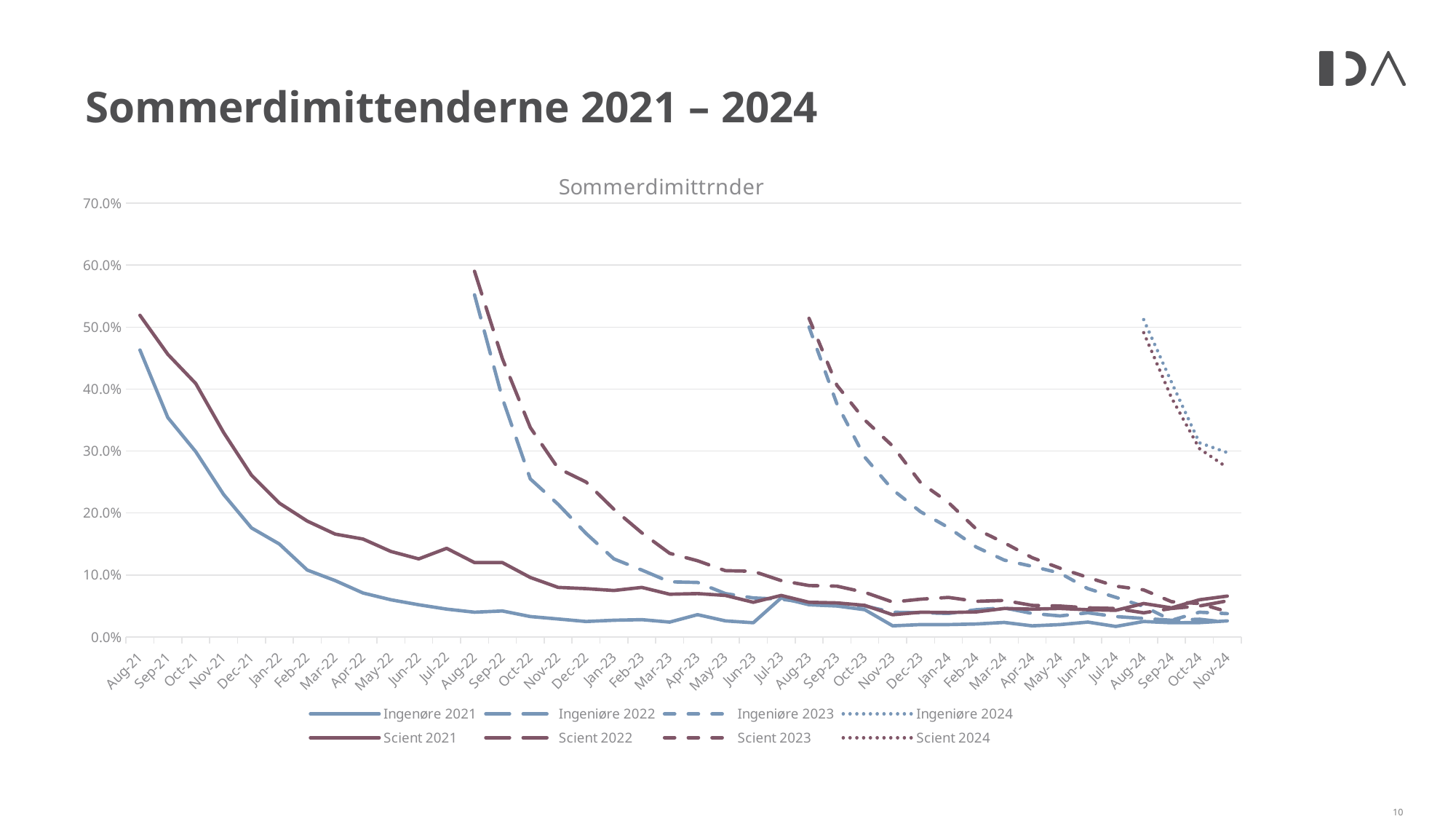
What kind of chart is shown on the slide? Line chart Is the value for Scient 2022 at Aug-22 greater or less than 50%? greater How many series does the legend list? 8 Is the value for Scient 2021 at Dec-21 greater or less than 20%? greater What is the title of the chart? Sommerdimittrnder How many months are shown on the x axis? 40 Is the value for Ingenøre 2021 at Dec-21 greater or less than 20%? less Does the Scient 2021 line rise or fall from Aug-21 to Nov-21? Fall At Aug-22, which series has the higher value: Scient 2022 or Ingeniøre 2022? Scient 2022